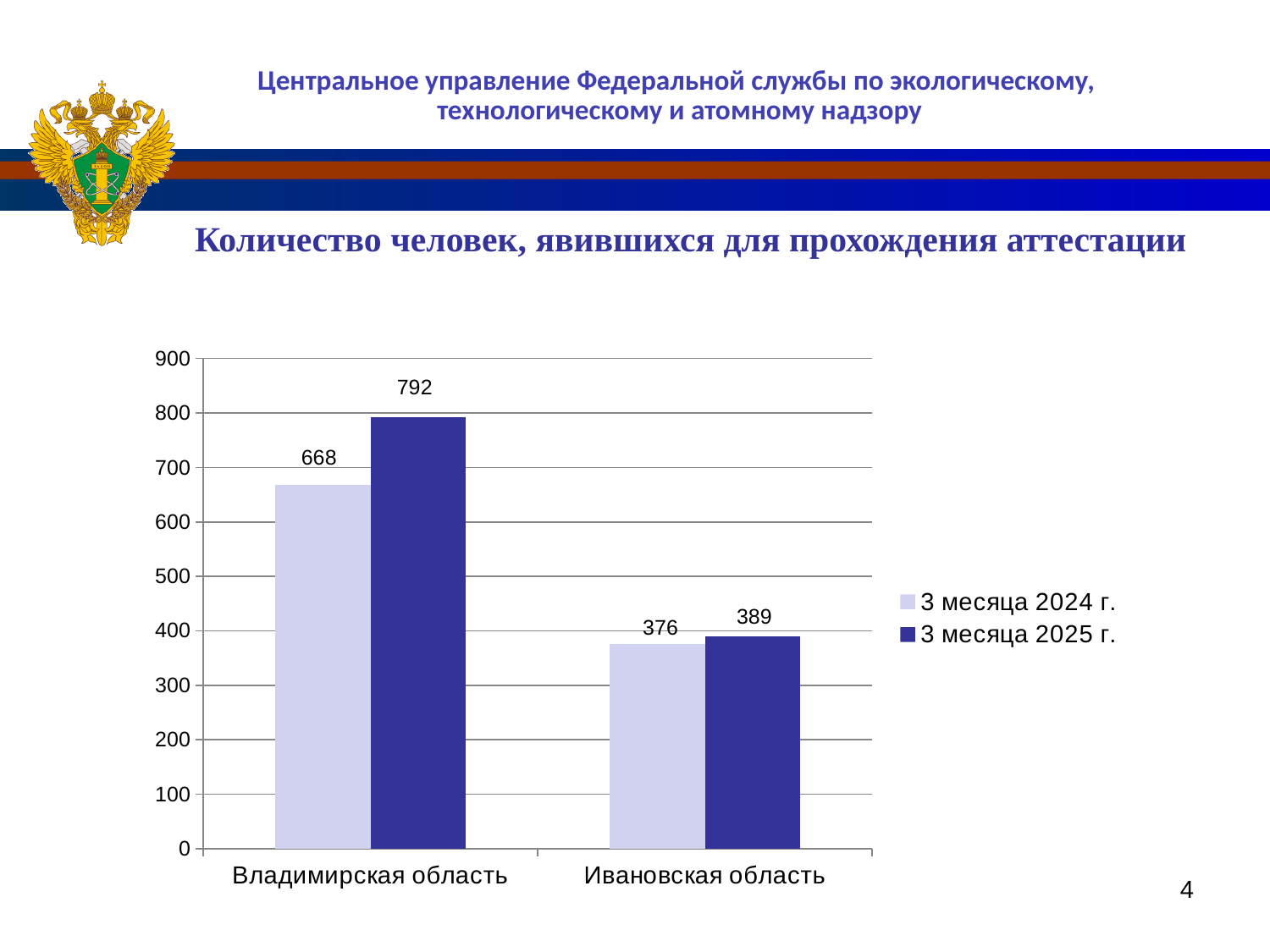
How many categories are shown on the x axis? 2 Is the value for Владимирская область in 3 месяца 2024 г. greater or less than 600? greater What is the value for Ивановская область in the series 3 месяца 2024 г.? 376 What is the value for Владимирская область in the series 3 месяца 2025 г.? 792 What is the value for Владимирская область in the series 3 месяца 2024 г.? 668 Which category has the highest value in the series 3 месяца 2025 г.? Владимирская область What is the difference between the 3 месяца 2025 г. and 3 месяца 2024 г. values for Владимирская область? 124 Which is larger for Ивановская область: the 3 месяца 2024 г. value or the 3 месяца 2025 г. value? 3 месяца 2025 г. How many series does the legend list? 2 What kind of chart is shown on the slide? bar chart What is the difference between the 3 месяца 2025 г. and 3 месяца 2024 г. values for Ивановская область? 13 Which category has the lowest value in the series 3 месяца 2024 г.? Ивановская область